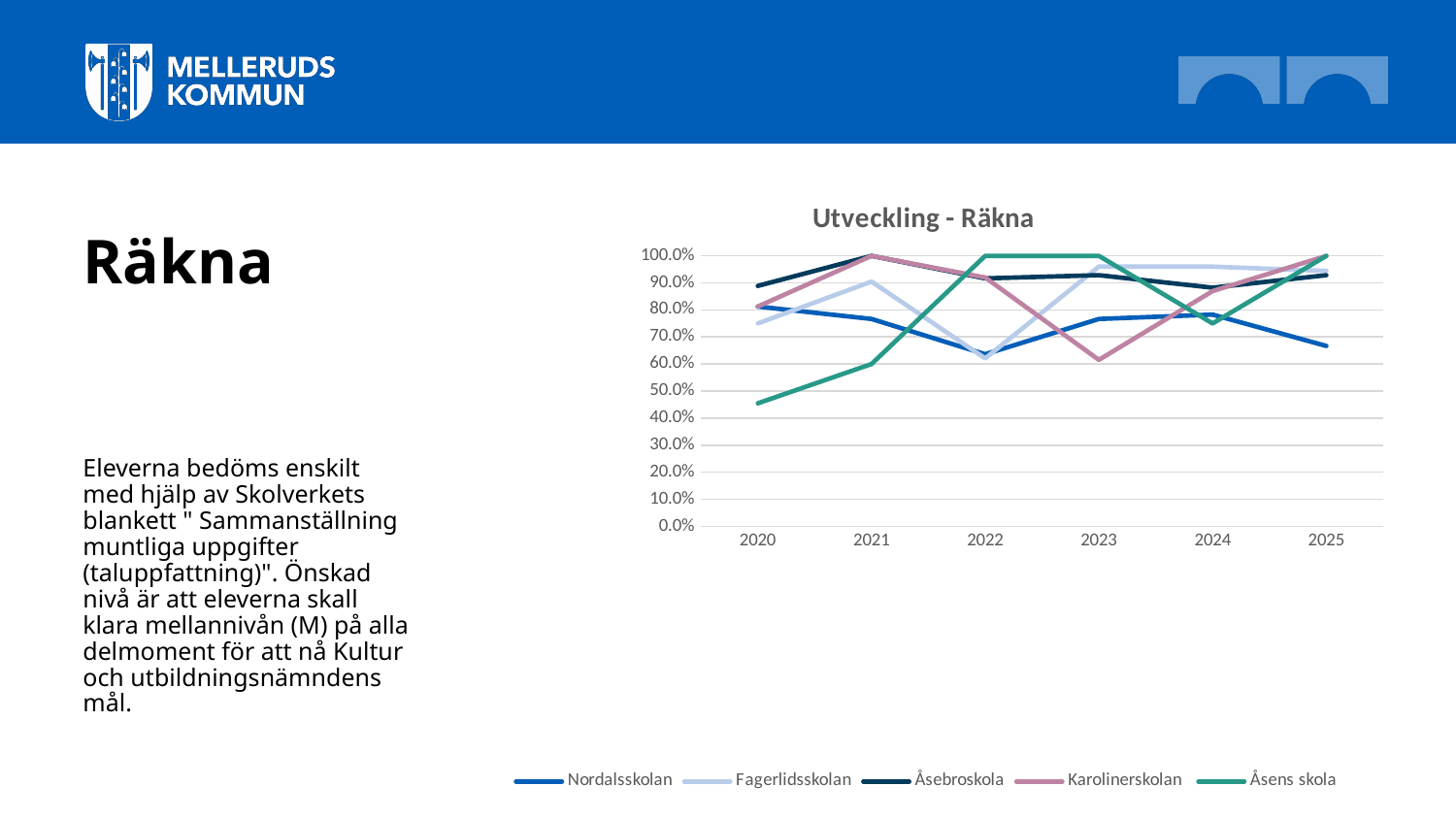
How many series does the legend of the chart list? 5 Is the value for Åsens skola in 2020 greater or less than 50%? less Which school has the lowest value in 2025? Nordalsskolan What is the value for Karolinerskolan in 2021? 100.0% What kind of chart is shown on the slide? line chart Does the value for Åsens skola rise or fall from 2020 to 2022? rise Is the value for Nordalsskolan in 2025 greater or less than 70%? less What is the value for Åsens skola in 2022? 100.0% How many years are shown on the x axis of the chart? 6 Which school has the lowest value in 2020? Åsens skola Which is larger in 2020, the value for Åsebroskola or the value for Nordalsskolan? Åsebroskola What is the title of the chart? Utveckling - Räkna